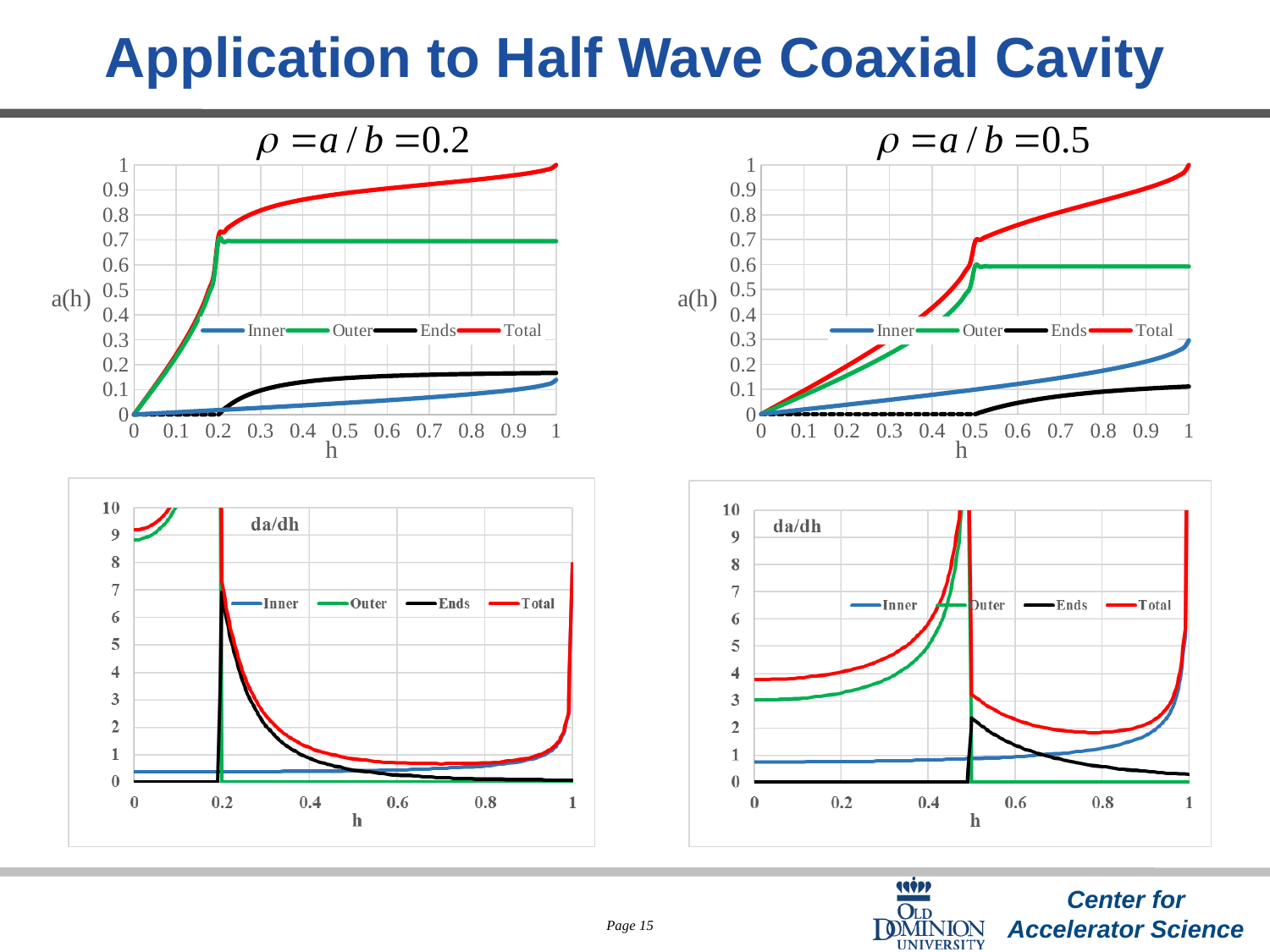
In the top-left chart (ρ = a/b = 0.2, a(h)), is the value of Total at h = 0.5 greater or less than 0.8? greater How many charts are shown on the slide? 4 In the top-left chart (ρ = a/b = 0.2, a(h)), what is the value of Total at h = 1? 1 In the top-left chart (ρ = a/b = 0.2, a(h)), how many series does the legend list? 4 What kind of chart is the top-left chart (ρ = a/b = 0.2, a(h))? line chart In the top-right chart (ρ = a/b = 0.5, a(h)), is the value of Inner at h = 1 greater or less than 0.4? less In the top-right chart (ρ = a/b = 0.5, a(h)), does the Inner series rise or fall as h increases? rise In the top-left chart (ρ = a/b = 0.2, a(h)), which series has the highest value at h = 1? Total In the top-right chart (ρ = a/b = 0.5, a(h)), which series has the lowest value at h = 1? Ends In the top-right chart (ρ = a/b = 0.5, a(h)), what is the value of Total at h = 1? 1 In the top-left chart (ρ = a/b = 0.2, a(h)), at h = 1, which is larger: Outer or Inner? Outer In the bottom-left chart (da/dh, ρ = 0.2), is the value of Total at h = 0 greater or less than 8? greater